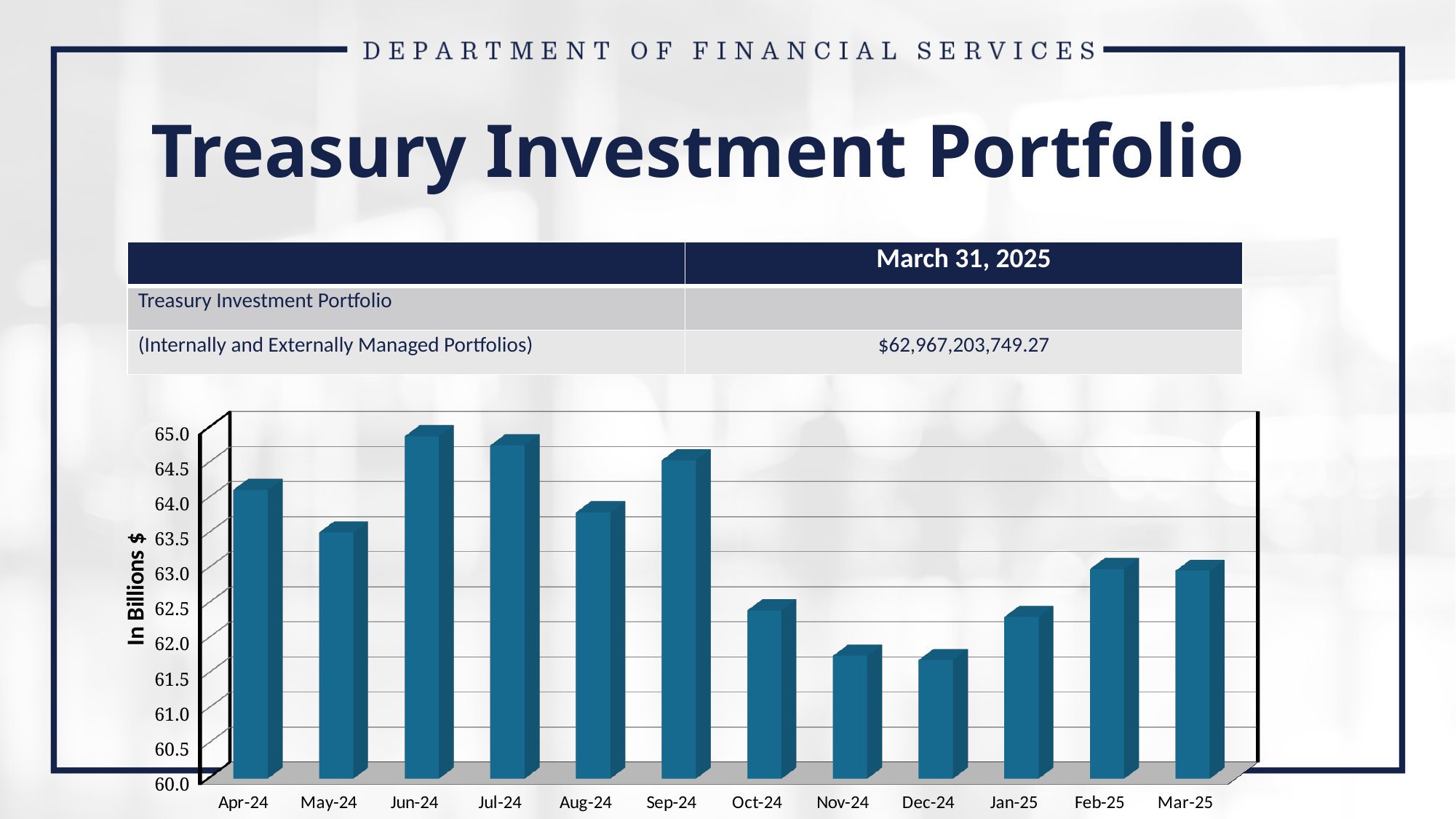
Is the value for Jun-24 greater or less than 64.5? greater Which is larger, the value for Sep-24 or the value for Nov-24? Sep-24 Which is larger, the value for Apr-24 or the value for May-24? Apr-24 Is the value for Oct-24 greater or less than 63.0? less What kind of chart is shown on the slide? bar chart Is the value for Nov-24 greater or less than 62.0? less Do the values rise or fall from Sep-24 to Dec-24? fall How many months are plotted on the chart? 12 What is the label on the vertical axis of the chart? In Billions $ Which is larger, the value for Jun-24 or the value for Oct-24? Jun-24